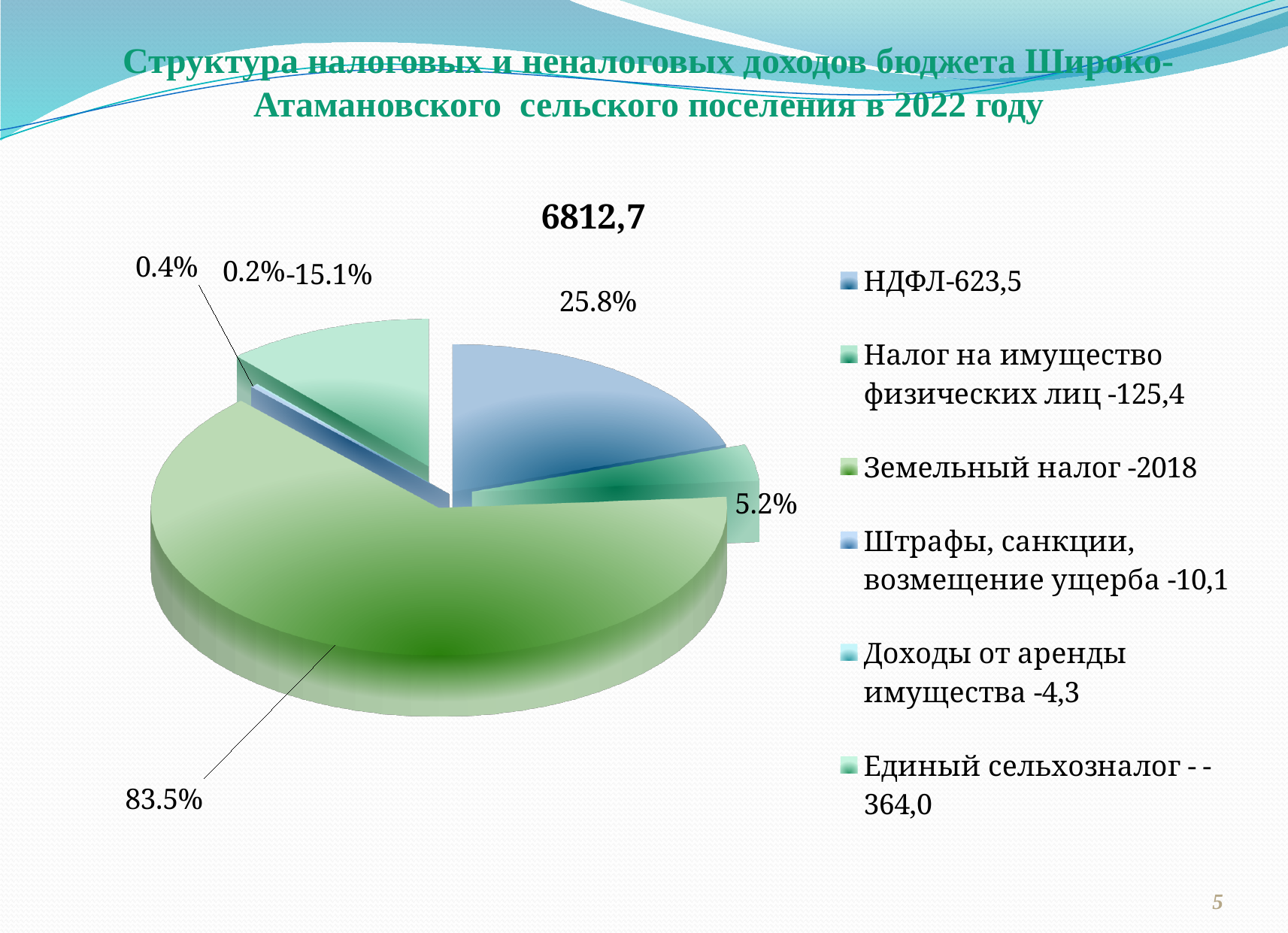
Which category has the largest slice of the pie chart? Земельный налог What value is given in the legend for Штрафы, санкции, возмещение ущерба? 10,1 What percentage label is shown for the Единый сельхозналог slice? -15.1% What value is given in the legend for Земельный налог? 2018 What is the title shown above the pie chart? 6812,7 By how many percentage points does the НДФЛ slice exceed the Налог на имущество физических лиц slice? 20.6 What kind of chart is shown on the slide? pie chart What percentage label is shown for the Земельный налог slice? 83.5% How many categories does the legend of the pie chart list? 6 What percentage label is shown for the Налог на имущество физических лиц slice? 5.2% Which slice is larger, НДФЛ or Налог на имущество физических лиц? НДФЛ